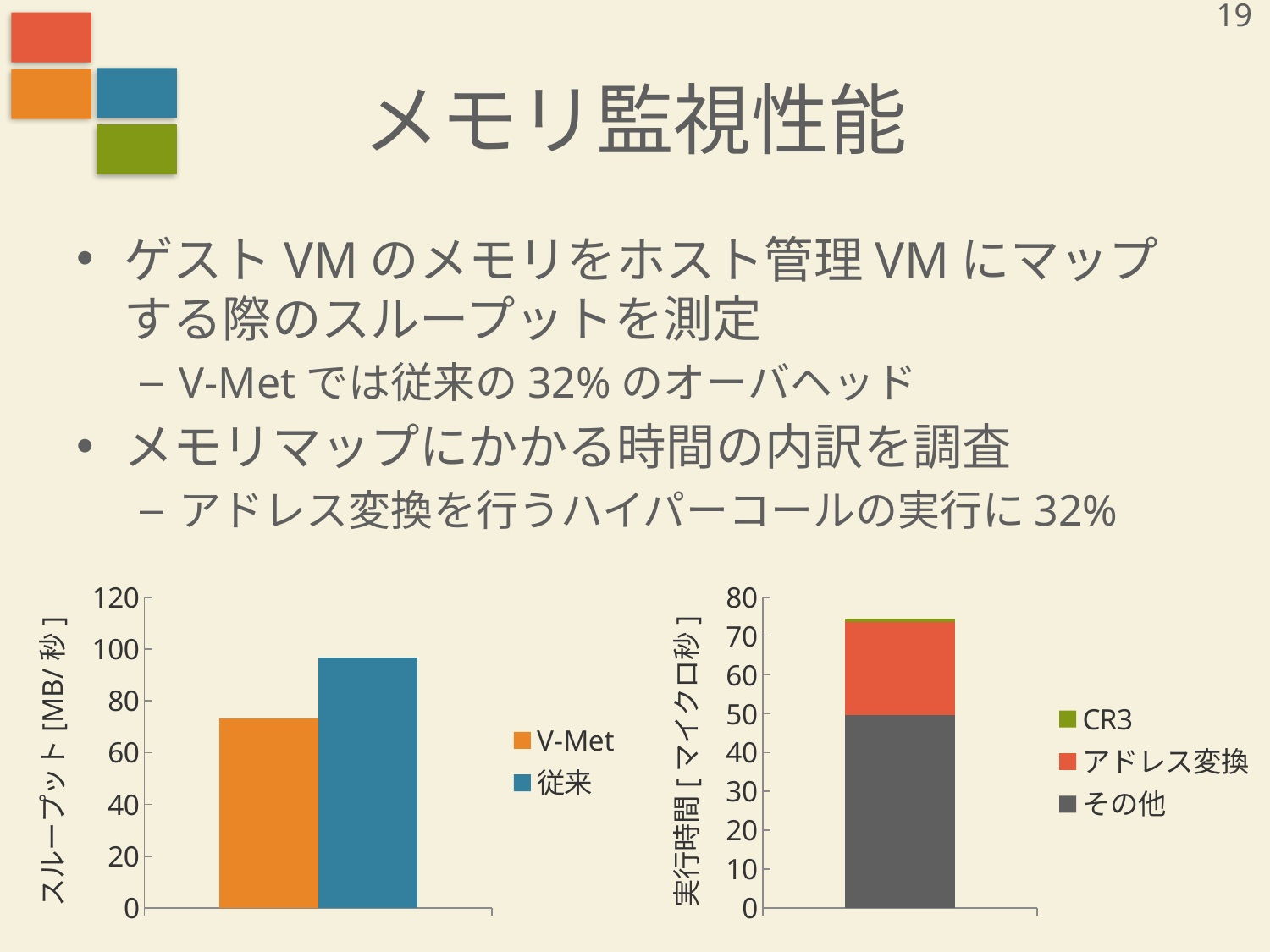
In the left chart, is the value for V-Met greater or less than 80? less In the right chart, is the その他 segment greater or less than 40? greater In the left chart, which series has the lowest throughput? V-Met In the right chart, which segment is the largest? その他 In the left chart, is the value for 従来 greater or less than 80? greater In the right chart, how many series does the legend list? 3 What kind of chart is the left chart on the slide? bar chart What is the y-axis label of the left chart? スループット [MB/秒] In the left chart, how many series does the legend list? 2 In the left chart, which series has the higher throughput, V-Met or 従来? 従来 What kind of chart is the right chart on the slide? stacked bar chart